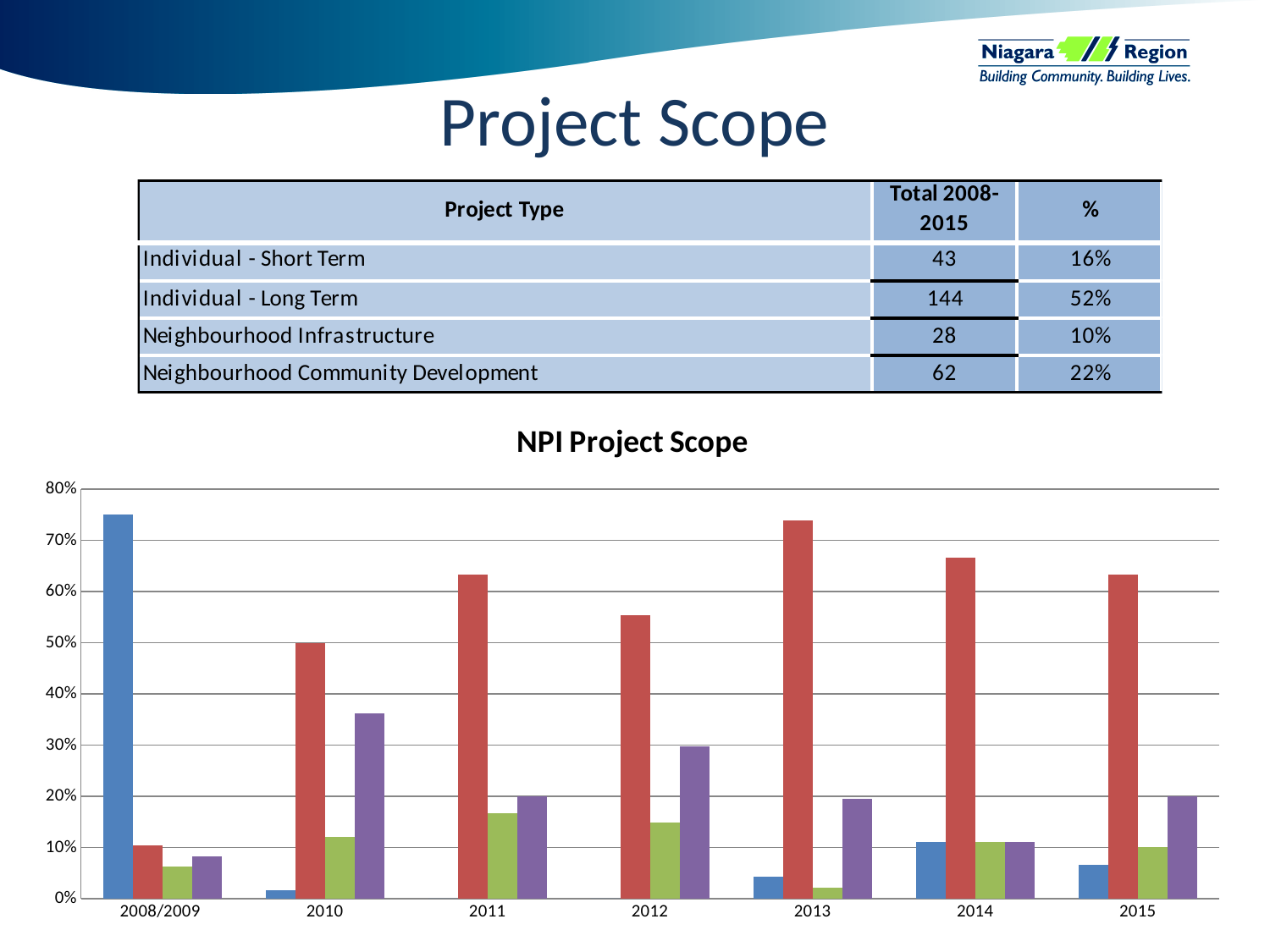
In the NPI Project Scope chart, is the purple bar for 2010 greater or less than 30%? greater In the NPI Project Scope chart, which year has the tallest red bar? 2013 In the NPI Project Scope chart, is the red bar for 2012 greater or less than 50%? greater How many differently coloured bar series are plotted for each year in the NPI Project Scope chart? 4 In the NPI Project Scope chart, is the blue bar for 2008/2009 greater or less than 70%? greater What kind of chart is the NPI Project Scope chart? bar chart How many year categories are shown on the x axis of the NPI Project Scope chart? 7 In the NPI Project Scope chart, is the red bar taller for 2011 or for 2012? 2011 In the NPI Project Scope chart, which year has the shortest red bar? 2008/2009 What is the title of the chart on the slide? NPI Project Scope